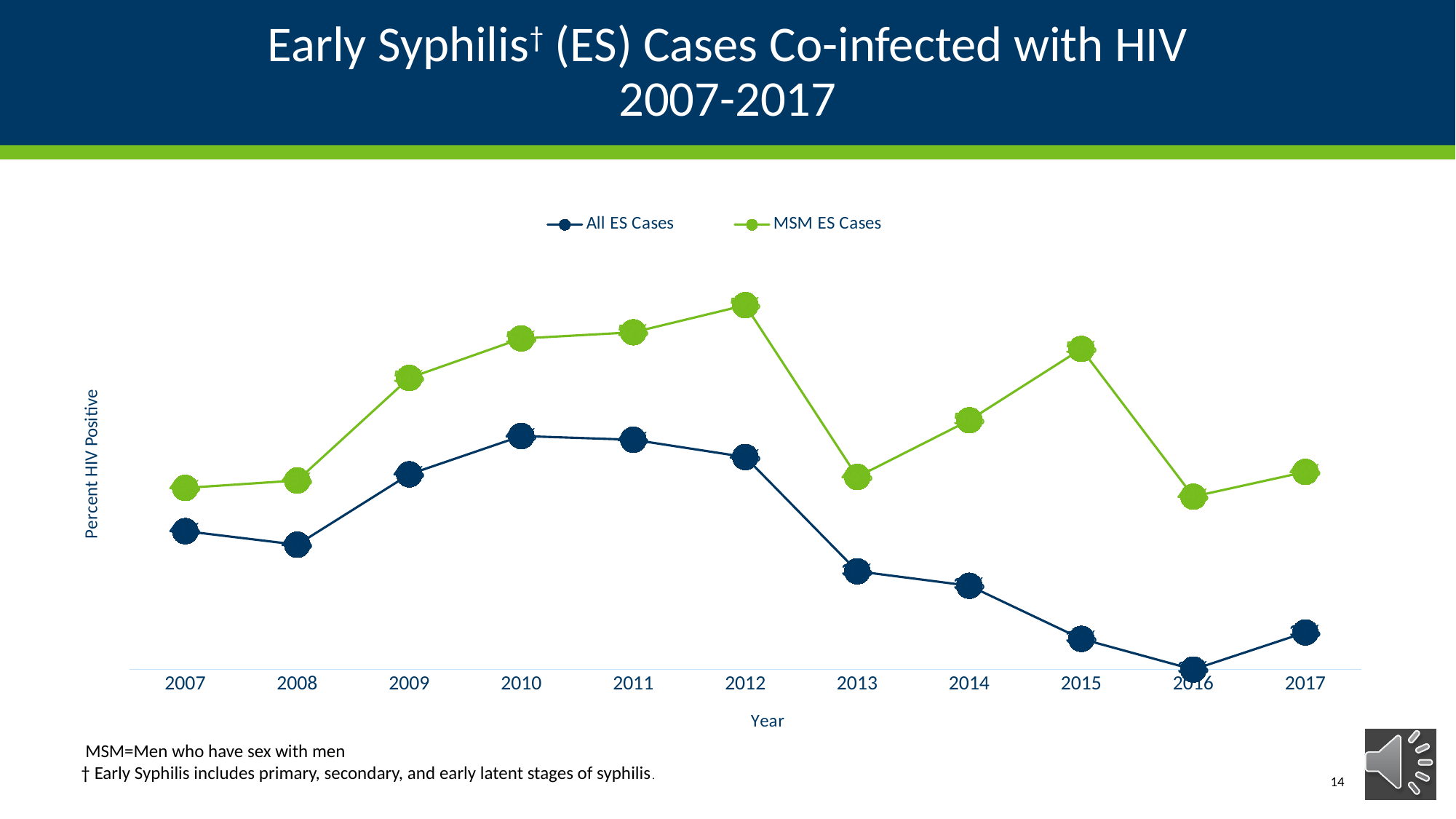
What kind of chart is shown on the slide? Line chart How many series does the legend list? 2 How many years are plotted along the x axis? 11 In which year does the MSM ES Cases series reach its highest value? 2012 In which year does the All ES Cases series reach its lowest value? 2016 Which series is drawn in green? MSM ES Cases Does the All ES Cases series rise or fall from 2012 to 2016? Fall What is the label on the y axis? Percent HIV Positive For MSM ES Cases, which year has the larger value, 2014 or 2015? 2015 Does the MSM ES Cases series rise or fall from 2008 to 2012? Rise For All ES Cases, which year has the larger value, 2012 or 2013? 2012 In 2010, which series has the higher percent HIV positive, All ES Cases or MSM ES Cases? MSM ES Cases